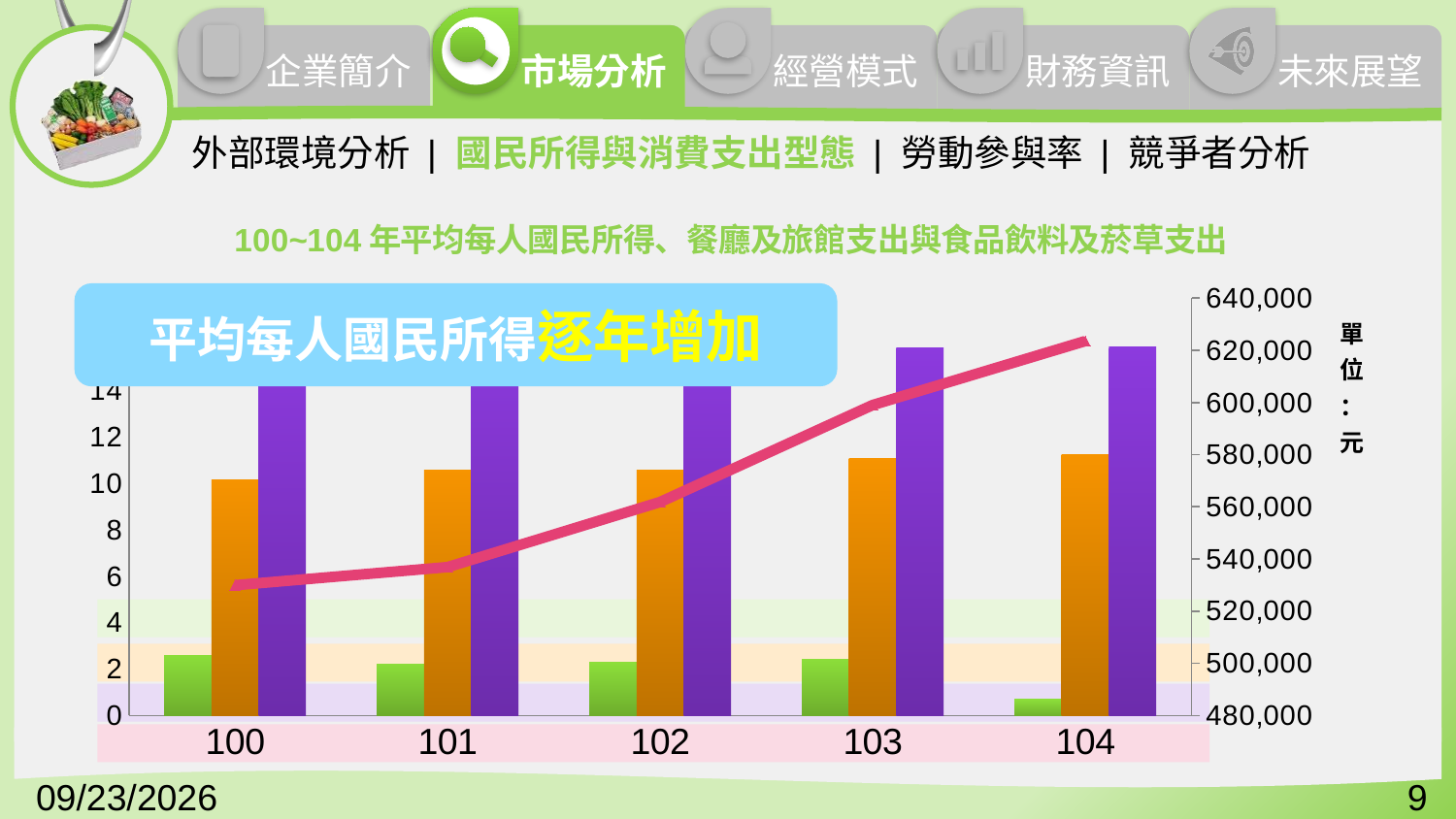
How many years (categories) are shown on the x axis of the chart? 5 Is the green bar for year 104 greater or less than 2 on the left axis? less Which is taller in the chart, the orange bar for year 100 or the orange bar for year 104? The orange bar for year 104 Does the pink line in the chart rise or fall from year 100 to year 104? It rises Which year has the lowest orange bar in the chart? 100 What kind of chart is shown on the slide? A combined bar and line chart Which year has the lowest green bar in the chart? 104 What unit is indicated next to the right-hand axis of the chart? 元 Is the value of the pink line at year 104 greater or less than 600,000 on the right axis? greater What is the title of the chart on the slide? 100~104 年平均每人國民所得、餐廳及旅館支出與食品飲料及菸草支出 Is the value of the pink line at year 100 greater or less than 540,000 on the right axis? less